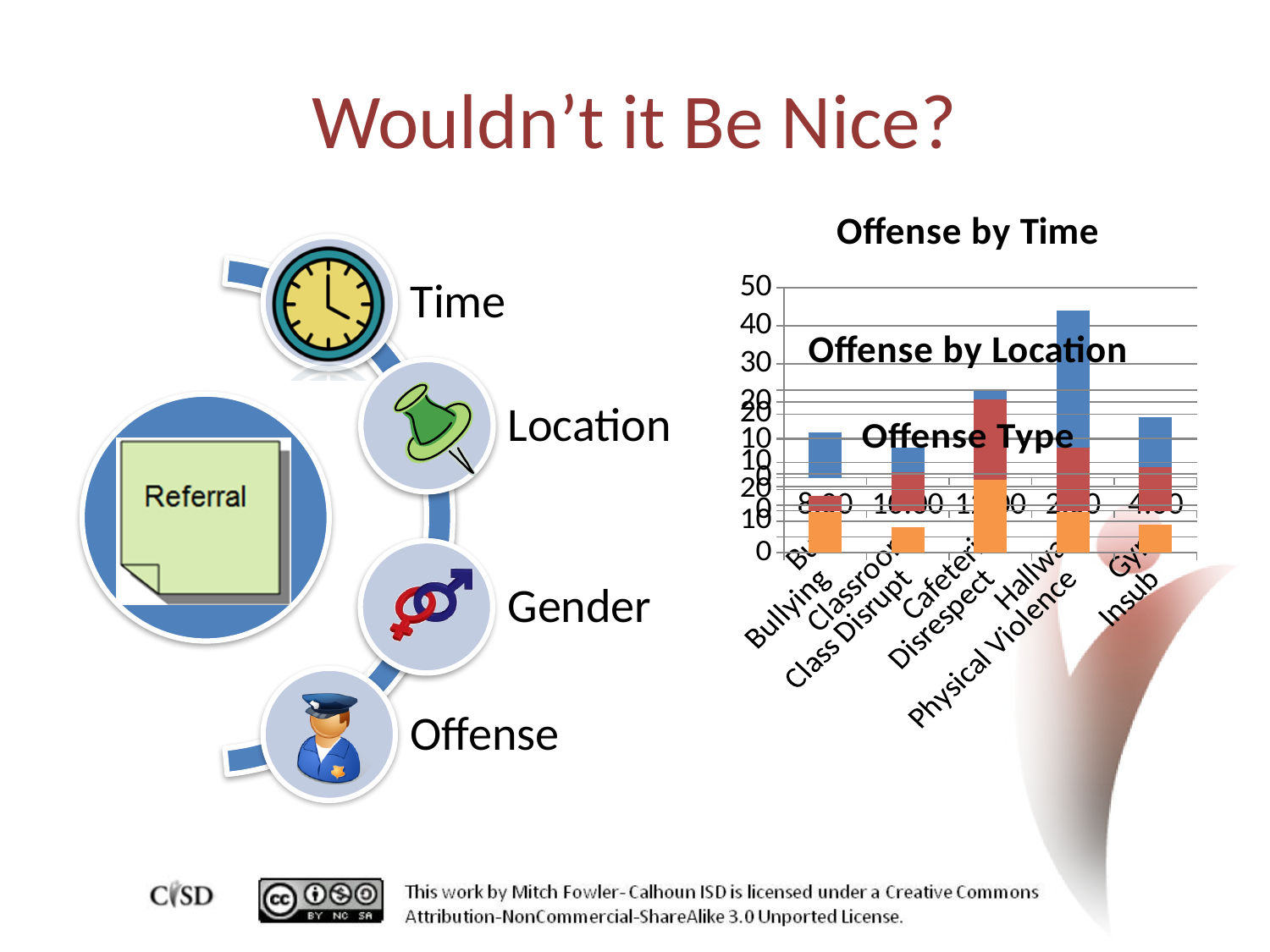
What kind of chart is the Offense Type chart? bar chart In the Offense by Time chart, what is the first label on the x axis? 8:00 How many charts are shown on the slide? 3 In the Offense by Time chart, what is the highest value shown on the y axis? 50 In the Offense Type chart, is the value for Disrespect greater or less than 10? greater In the Offense Type chart, which category has the highest value? Disrespect In the Offense Type chart, which is larger, Disrespect or Bullying? Disrespect In the Offense by Time chart, how many bars are plotted? 5 In the Offense by Time chart, is the tallest bar greater or less than 30? greater In the Offense Type chart, how many categories are plotted? 5 What is the title of the chart in front, at the bottom of the chart stack? Offense Type